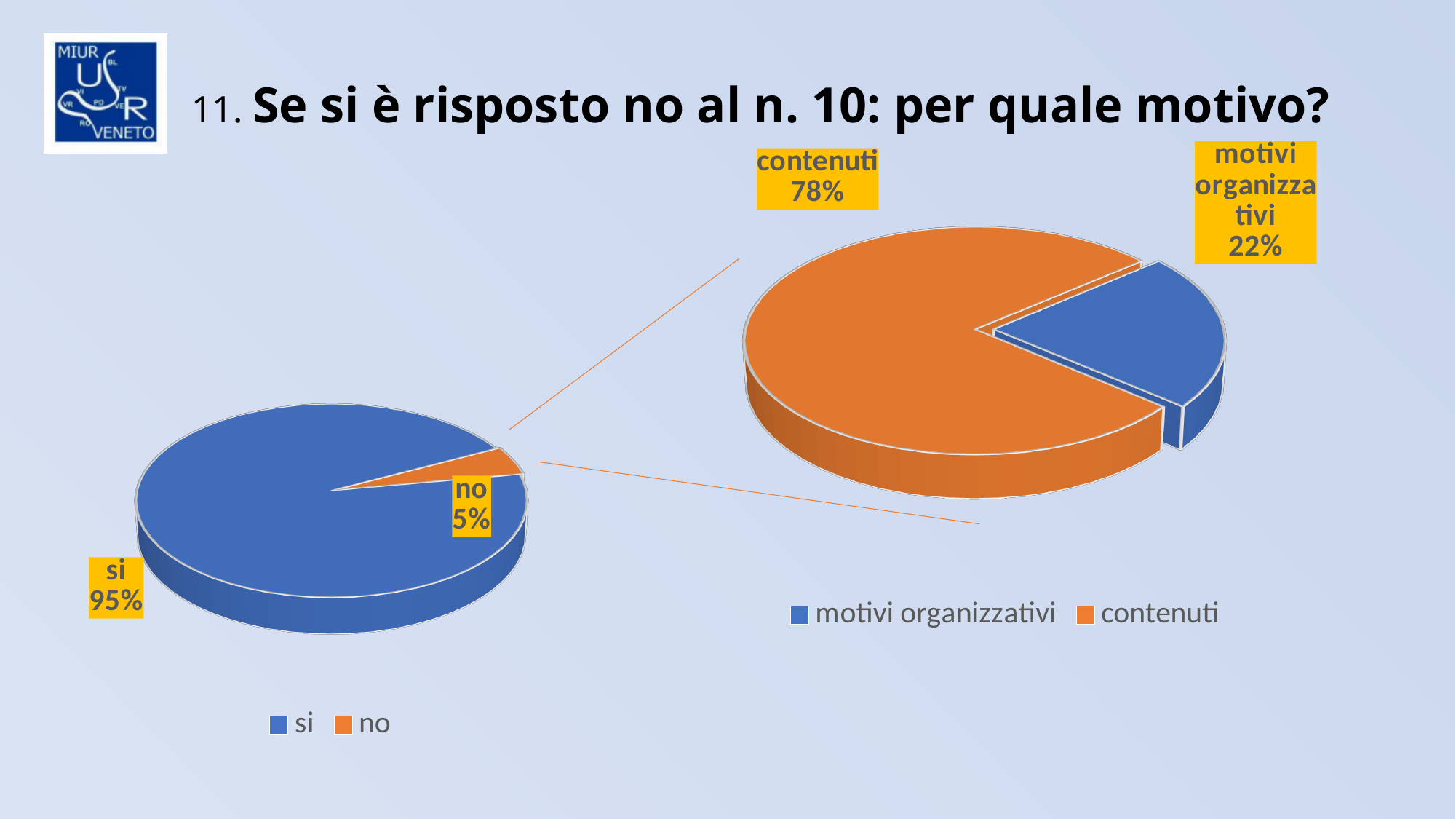
In the right pie chart (motivi organizzativi/contenuti), what percentage is shown for "contenuti"? 78% In the left pie chart (si/no), what percentage is shown for "no"? 5% In the right pie chart, what is the difference in percentage points between "contenuti" and "motivi organizzativi"? 56 What kind of chart is the left chart (si/no)? pie chart In the left pie chart, which category has the smallest share? no In the right pie chart (motivi organizzativi/contenuti), what percentage is shown for "motivi organizzativi"? 22% In the left pie chart, what is the difference in percentage points between "si" and "no"? 90 What colour is the "contenuti" slice in the right pie chart? orange In the left pie chart (si/no), what percentage is shown for "si"? 95% In the right pie chart, which category has the largest share? contenuti In the right pie chart, which is larger: "motivi organizzativi" or "contenuti"? contenuti How many slices does the right pie chart have? 2